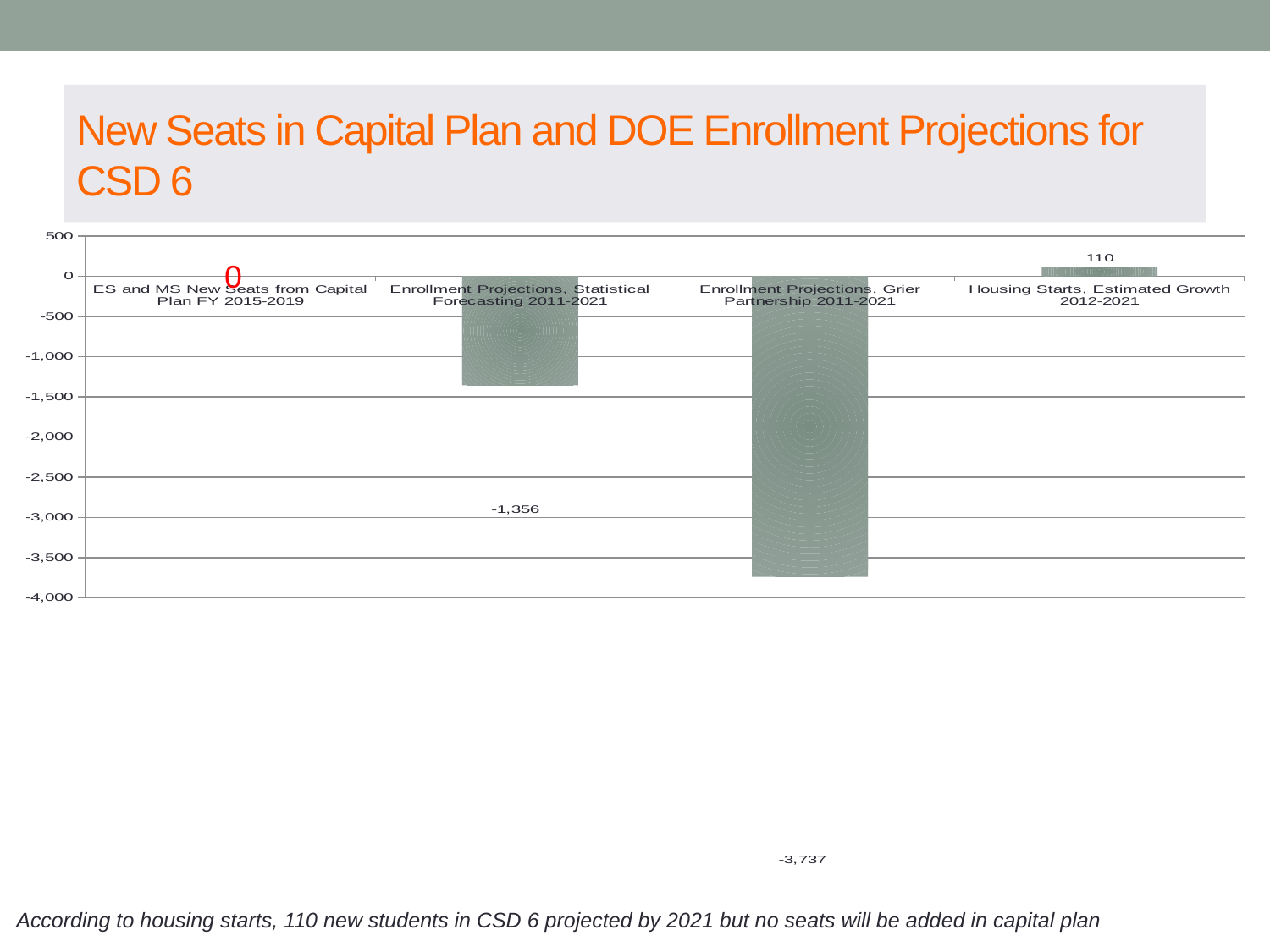
What is the title of the slide containing the chart? New Seats in Capital Plan and DOE Enrollment Projections for CSD 6 Which category has the highest value? Housing Starts, Estimated Growth 2012-2021 What is the value for Enrollment Projections, Statistical Forecasting 2011-2021? -1,356 What is the difference between the Statistical Forecasting projection and the Grier Partnership projection? 2,381 Which is larger, the value for Housing Starts, Estimated Growth 2012-2021 or the value for Enrollment Projections, Statistical Forecasting 2011-2021? Housing Starts, Estimated Growth 2012-2021 Is the value for Enrollment Projections, Grier Partnership 2011-2021 greater or less than -3,000? less What is the value for ES and MS New Seats from Capital Plan FY 2015-2019? 0 What kind of chart is shown on the slide? bar chart Which category has the lowest value? Enrollment Projections, Grier Partnership 2011-2021 What is the value for Enrollment Projections, Grier Partnership 2011-2021? -3,737 What is the value for Housing Starts, Estimated Growth 2012-2021? 110 How many categories are shown in the chart? 4